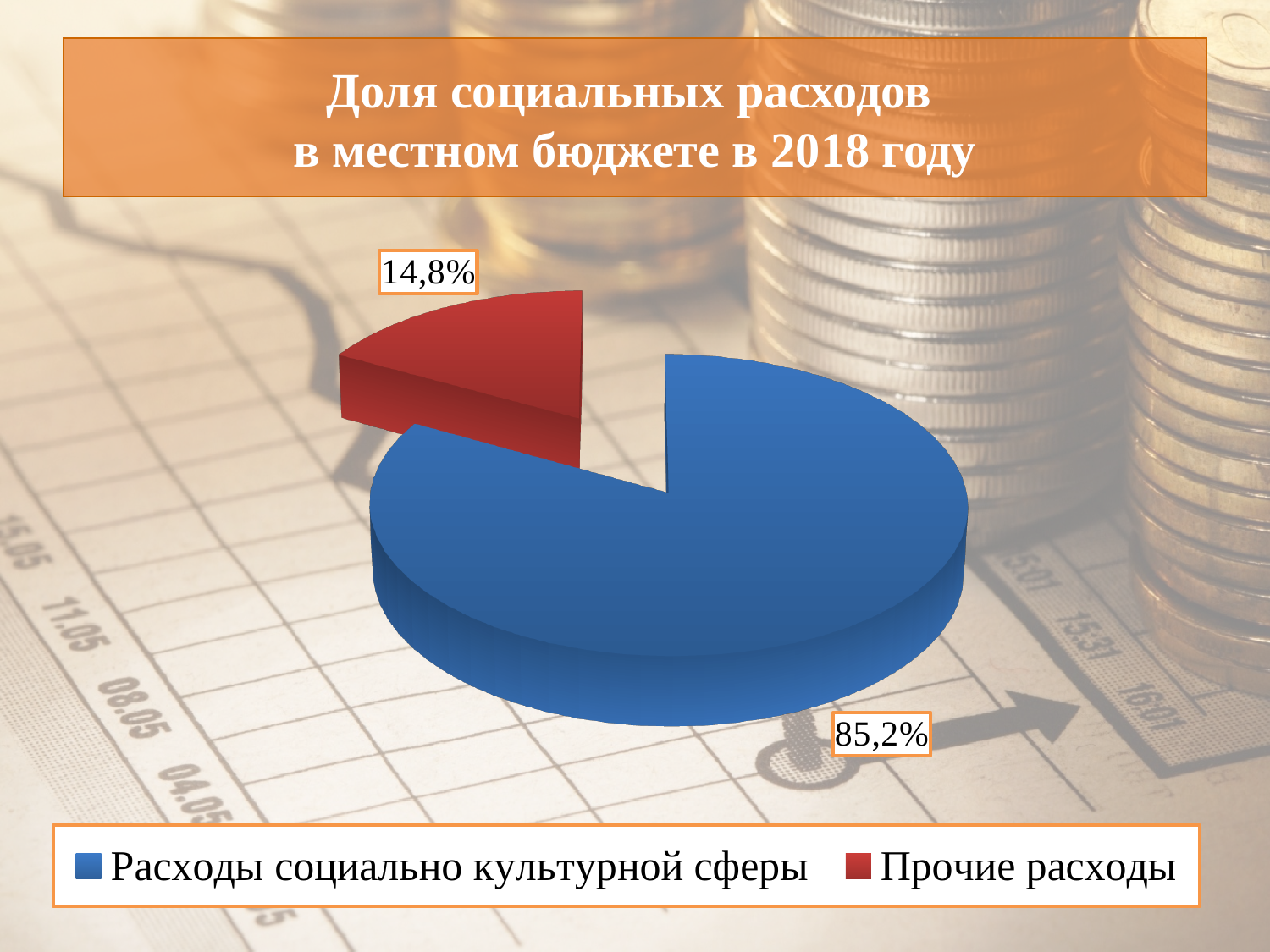
Which category has the smallest slice of the pie? Прочие расходы What share of the pie does "Расходы социально культурной сферы" take? 85,2% What is the difference in percentage points between "Расходы социально культурной сферы" and "Прочие расходы"? 70,4 What share of the pie does "Прочие расходы" take? 14,8% What colour is the slice for "Прочие расходы"? Red What kind of chart is shown on the slide? Pie chart What is the title of the chart? Доля социальных расходов в местном бюджете в 2018 году How many slices does the pie chart have? 2 How many entries does the legend list? 2 Which is larger: the share for "Расходы социально культурной сферы" or for "Прочие расходы"? Расходы социально культурной сферы Which category has the largest slice of the pie? Расходы социально культурной сферы